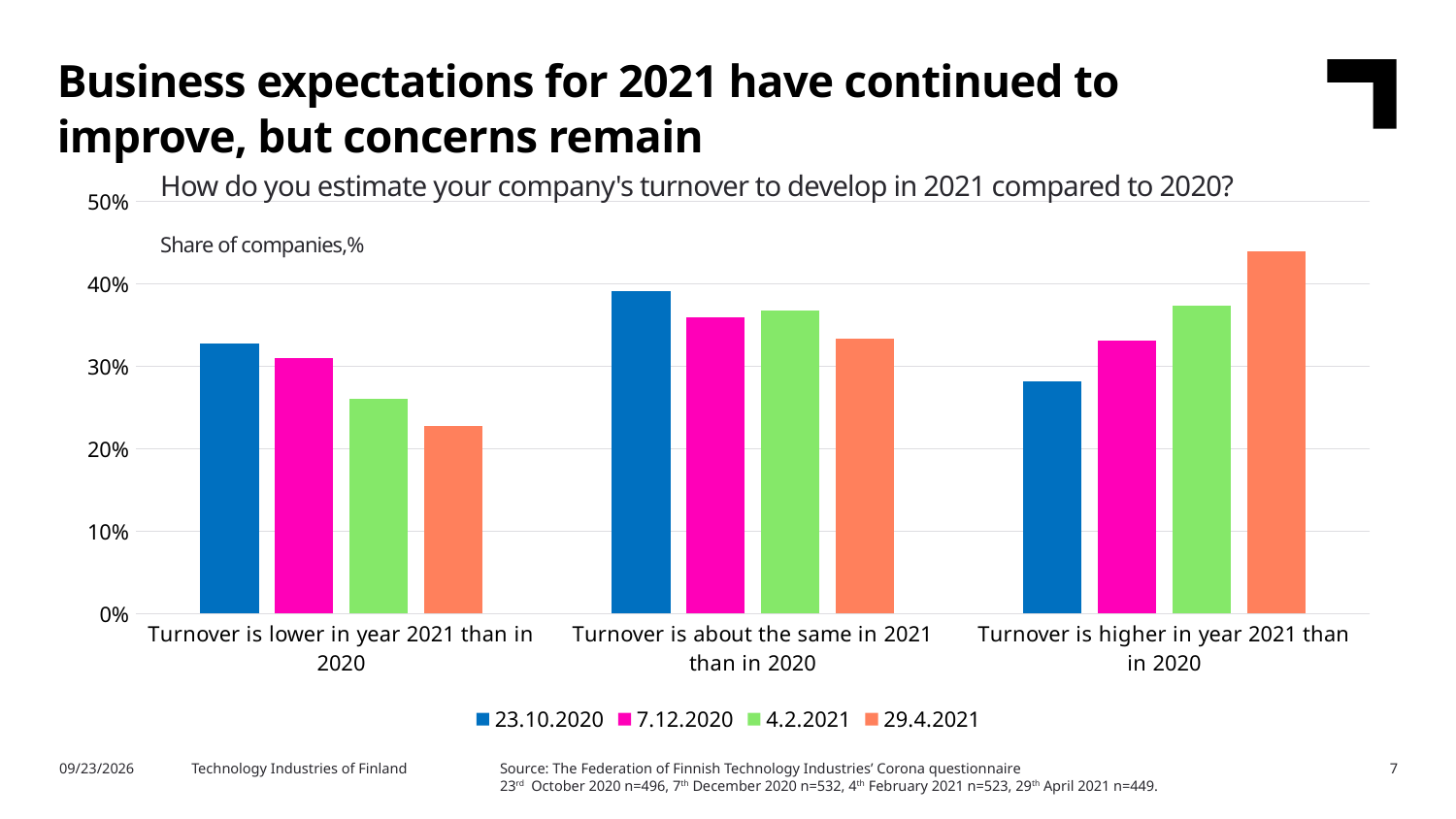
In the category 'Turnover is higher in year 2021 than in 2020', which survey date has the highest value? 29.4.2021 Is the value for 23.10.2020 in the category 'Turnover is about the same in 2021 than in 2020' greater or less than 30%? greater How many series does the legend list? 4 Is the value for 29.4.2021 in the category 'Turnover is higher in year 2021 than in 2020' greater or less than 40%? greater Across the survey dates from 23.10.2020 to 29.4.2021, do the values for 'Turnover is higher in year 2021 than in 2020' rise or fall? rise Is the value for 29.4.2021 in the category 'Turnover is lower in year 2021 than in 2020' greater or less than 30%? less For the 23.10.2020 series, which is larger: the value for 'Turnover is lower in year 2021 than in 2020' or for 'Turnover is higher in year 2021 than in 2020'? Turnover is lower in year 2021 than in 2020 What kind of chart is shown on the slide? bar chart For the 23.10.2020 series, which category has the highest value? Turnover is about the same in 2021 than in 2020 In the category 'Turnover is lower in year 2021 than in 2020', which survey date has the lowest value? 29.4.2021 What question is the chart titled with? How do you estimate your company's turnover to develop in 2021 compared to 2020? How many response categories are shown on the x axis? 3